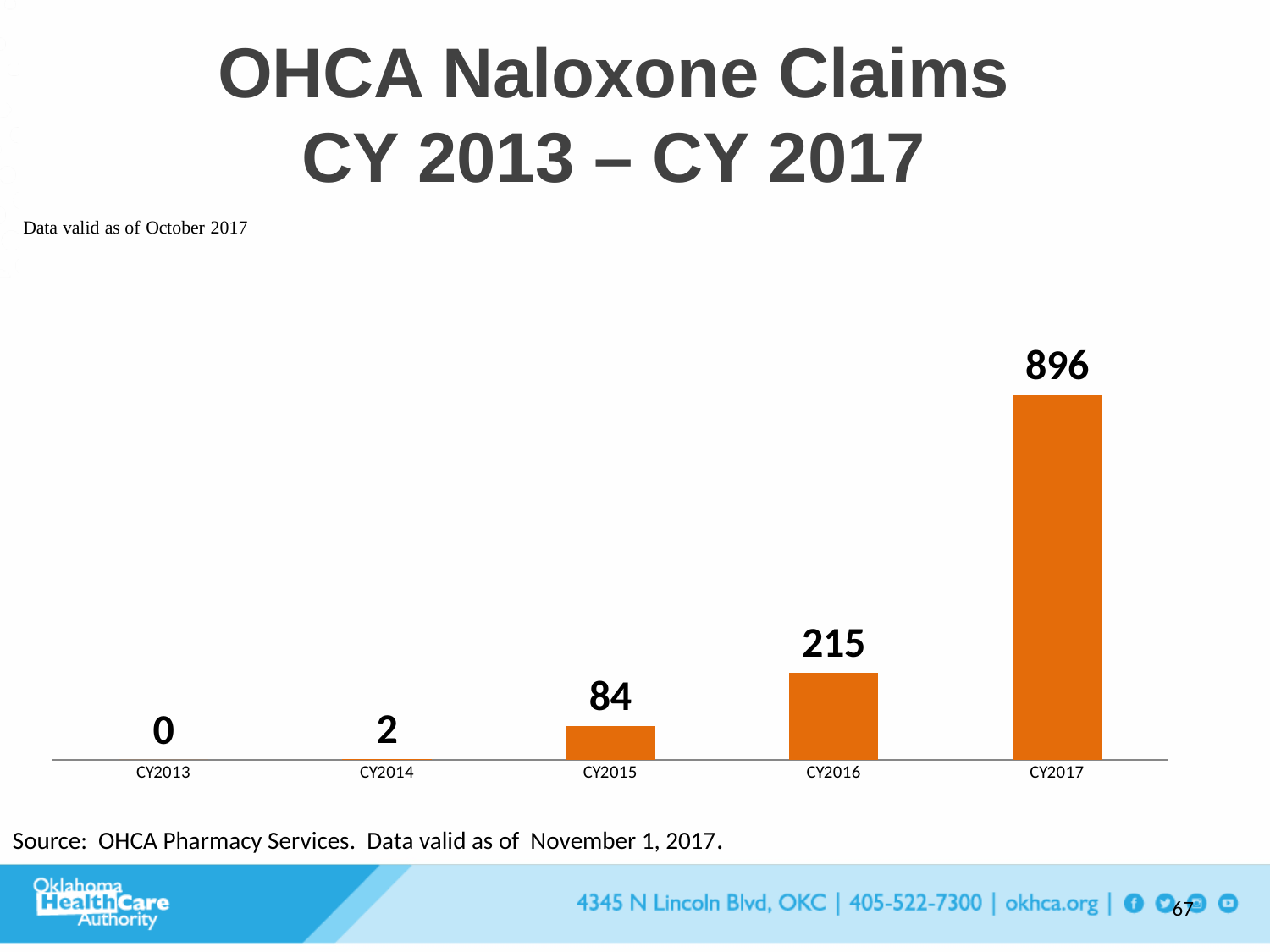
What is the number of naloxone claims for CY2017? 896 Which year has the lowest number of naloxone claims? CY2013 Do naloxone claims rise or fall from CY2013 to CY2017? Rise What kind of chart is shown on the slide? Bar chart What is the number of naloxone claims for CY2016? 215 Which year has more naloxone claims, CY2015 or CY2016? CY2016 Which year has the highest number of naloxone claims? CY2017 What is the number of naloxone claims for CY2014? 2 What is the number of naloxone claims for CY2015? 84 What is the difference in naloxone claims between CY2017 and CY2016? 681 What is the difference in naloxone claims between CY2016 and CY2015? 131 How many years are shown on the x axis of the chart? 5